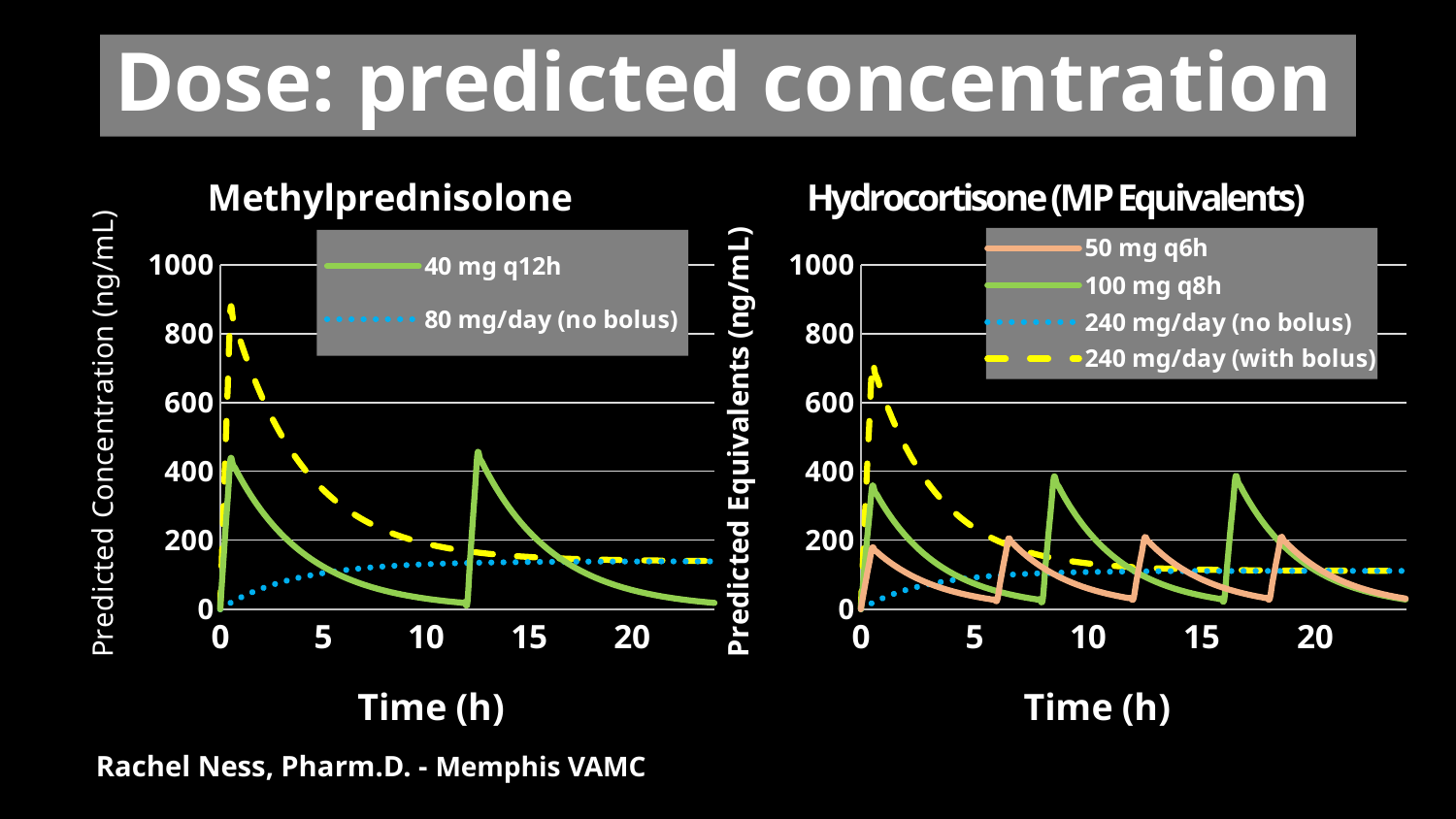
What is the x-axis title of the Hydrocortisone (MP Equivalents) chart? Time (h) In the Hydrocortisone (MP Equivalents) chart, is the peak value of the 240 mg/day (with bolus) series greater or less than 600? greater In the Methylprednisolone chart, does the 80 mg/day (no bolus) series rise or fall over time? rise How many series does the legend of the Hydrocortisone (MP Equivalents) chart list? 4 In the Methylprednisolone chart, is the peak value of the 40 mg q12h series greater or less than 600? less In the Hydrocortisone (MP Equivalents) chart, which series reaches the highest value? 240 mg/day (with bolus) What kind of chart is the Methylprednisolone chart? line chart In the Methylprednisolone chart, is the value of the 80 mg/day (no bolus) series at 20 h greater or less than 200? less How many series does the legend of the Methylprednisolone chart list? 2 In the Hydrocortisone (MP Equivalents) chart, which series has the higher peak, 100 mg q8h or 50 mg q6h? 100 mg q8h What is the y-axis title of the Methylprednisolone chart? Predicted Concentration (ng/mL)